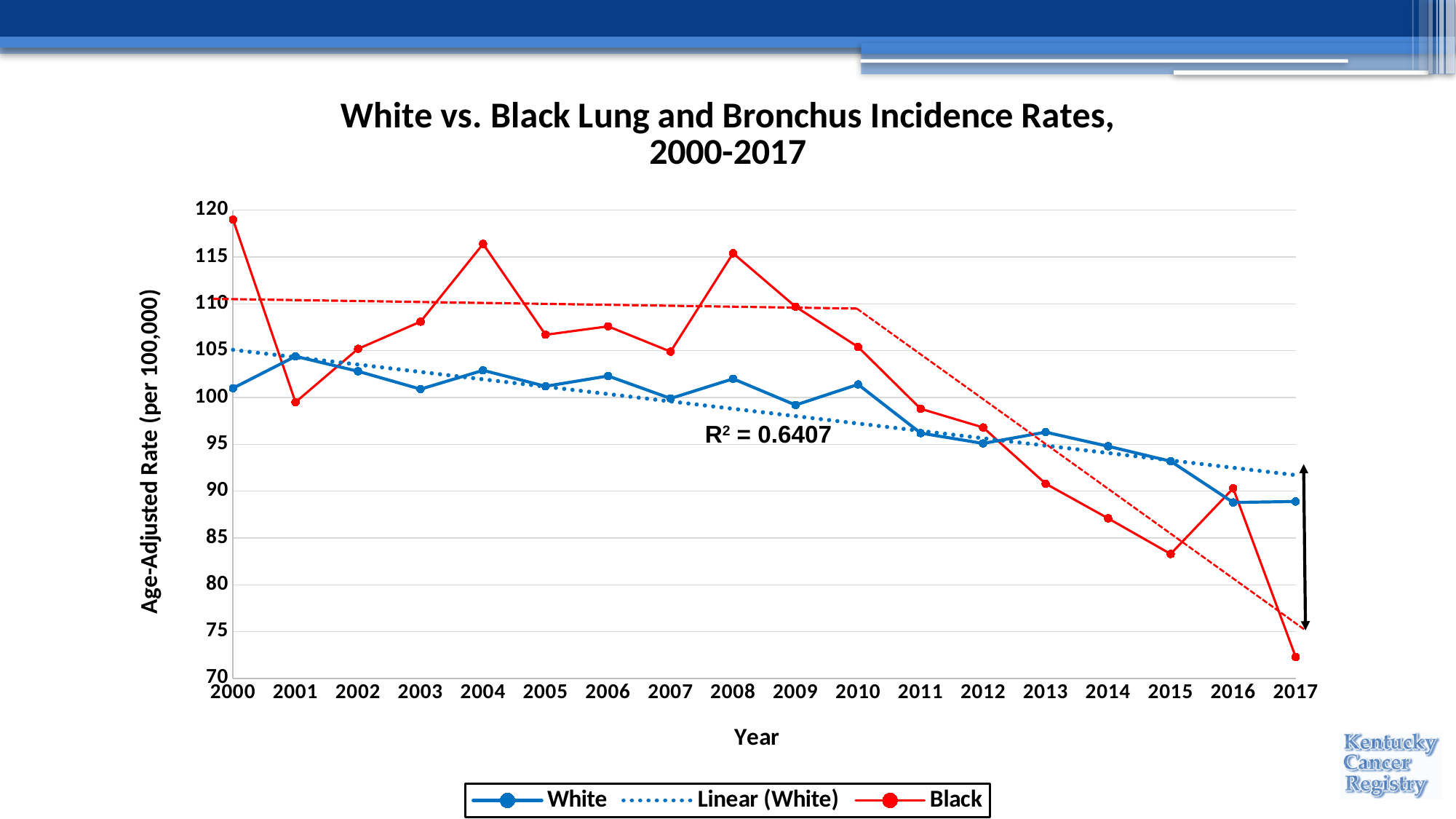
What R-squared value is printed on the chart? R² = 0.6407 Is the White rate in 2015 greater or less than 90? greater In which year is the Black incidence rate highest? 2000 In 2017, which series has the higher rate, White or Black? White How many entries does the legend list? 3 Is the Black rate in 2000 greater or less than 115? greater Is the Black rate in 2017 greater or less than 75? less How many years are plotted along the x axis? 18 Does the Black incidence rate generally rise or fall from 2000 to 2017? fall What kind of chart is shown on the slide? line chart In which year is the White incidence rate highest? 2001 In which year is the Black incidence rate lowest? 2017